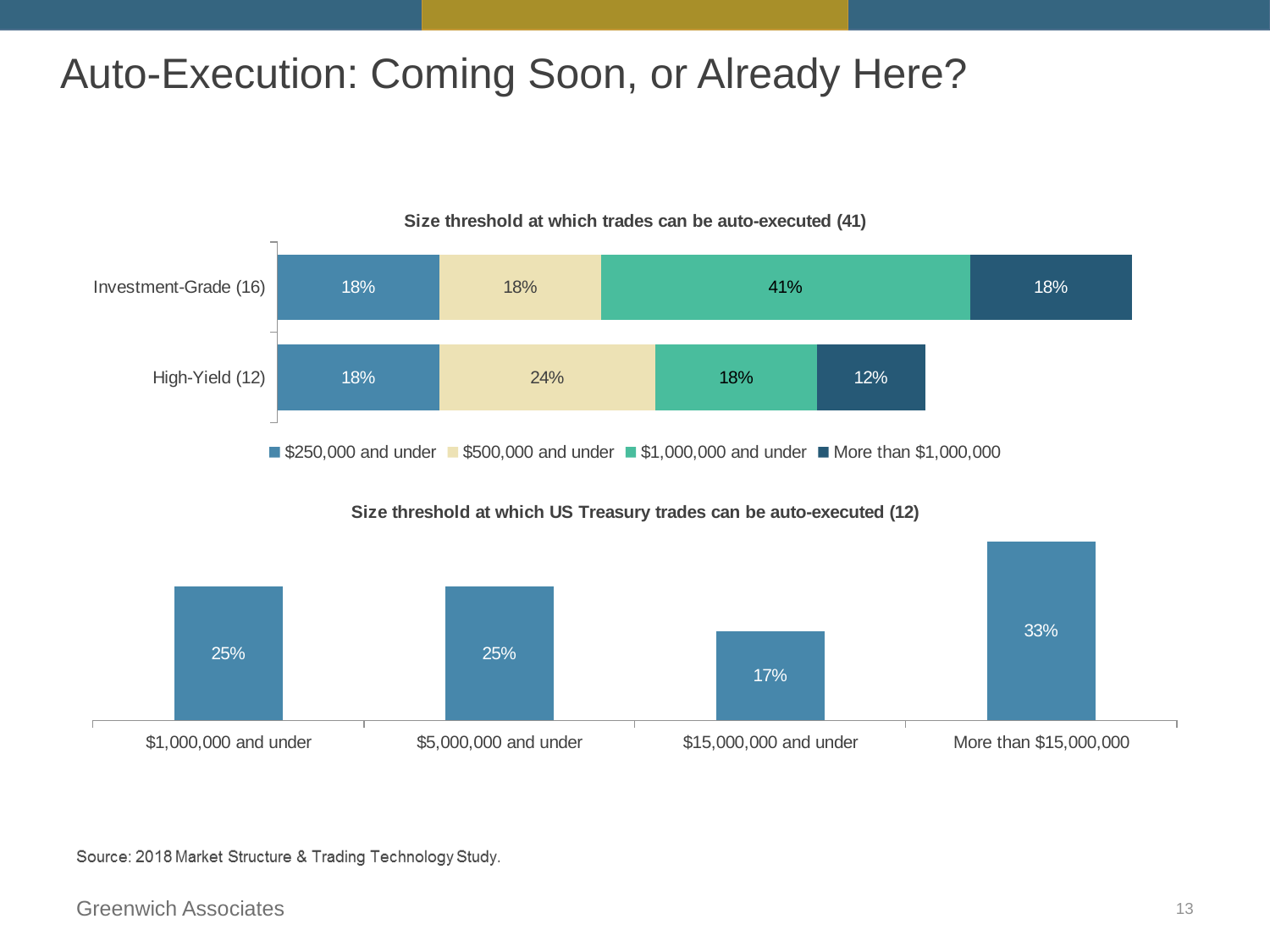
In the chart titled 'Size threshold at which trades can be auto-executed (41)', how many series does the legend list? 4 In the chart titled 'Size threshold at which US Treasury trades can be auto-executed (12)', which category has the lowest value? $15,000,000 and under In the chart titled 'Size threshold at which trades can be auto-executed (41)', what is the value for '$500,000 and under' for High-Yield (12)? 24% In the chart titled 'Size threshold at which trades can be auto-executed (41)', what kind of chart is shown? Stacked bar chart In the chart titled 'Size threshold at which US Treasury trades can be auto-executed (12)', what is the difference between the values for 'More than $15,000,000' and '$15,000,000 and under'? 16% In the chart titled 'Size threshold at which trades can be auto-executed (41)', what is the value for '$1,000,000 and under' for Investment-Grade (16)? 41% In the chart titled 'Size threshold at which US Treasury trades can be auto-executed (12)', which category has the highest value? More than $15,000,000 In the chart titled 'Size threshold at which trades can be auto-executed (41)', which is larger for '$1,000,000 and under': Investment-Grade (16) or High-Yield (12)? Investment-Grade (16) In the chart titled 'Size threshold at which trades can be auto-executed (41)', what is the difference between the '$500,000 and under' values for High-Yield (12) and Investment-Grade (16)? 6% In the chart titled 'Size threshold at which US Treasury trades can be auto-executed (12)', what is the value for 'More than $15,000,000'? 33% In the chart titled 'Size threshold at which US Treasury trades can be auto-executed (12)', how many categories are shown? 4 In the chart titled 'Size threshold at which trades can be auto-executed (41)', what is the value for 'More than $1,000,000' for High-Yield (12)? 12%